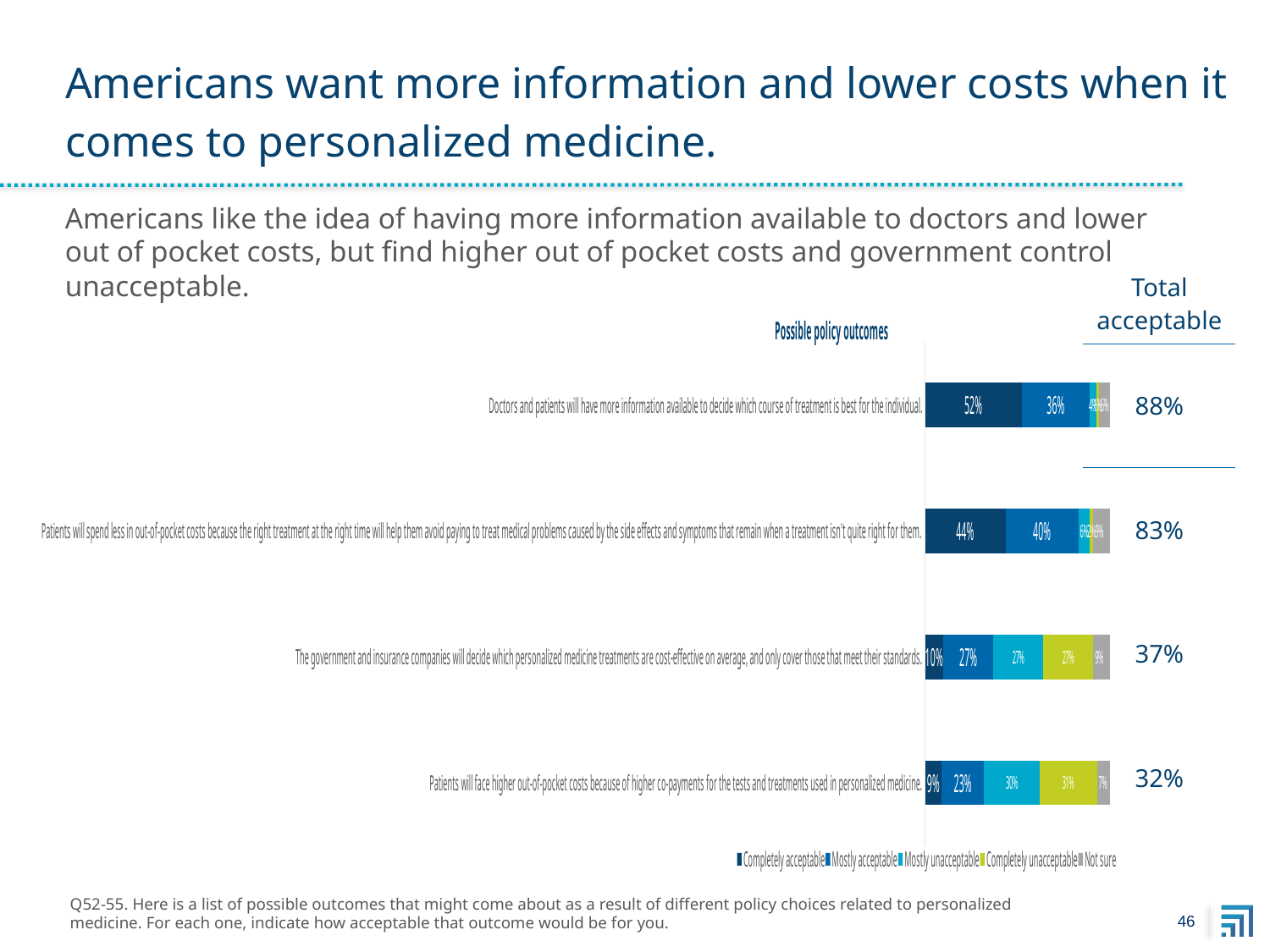
How many series does the chart legend list? 5 Which policy outcome has the lowest total acceptable percentage? Patients will face higher out-of-pocket costs because of higher co-payments for the tests and treatments used in personalized medicine. What is the difference between the total acceptable percentages for the 'more information available' outcome and the 'spend less in out-of-pocket costs' outcome? 5% Which policy outcome has the highest total acceptable percentage? Doctors and patients will have more information available to decide which course of treatment is best for the individual. What is the 'Not sure' value for the outcome that the government and insurance companies will decide which personalized medicine treatments are cost-effective? 9% What percentage of respondents find it completely acceptable that doctors and patients will have more information available to decide which course of treatment is best for the individual? 52% What is the title of the chart? Possible policy outcomes What is the 'Mostly acceptable' value for the outcome that patients will spend less in out-of-pocket costs? 40% Which is larger: the 'Completely acceptable' share for the government and insurance companies deciding outcome, or the 'Completely acceptable' share for the higher out-of-pocket costs outcome? The government and insurance companies deciding outcome (10%) What is the 'Completely unacceptable' value for the outcome that patients will face higher out-of-pocket costs because of higher co-payments? 31% What kind of chart is shown on the slide? Stacked bar chart How many policy outcomes (categories) are plotted in the chart? 4